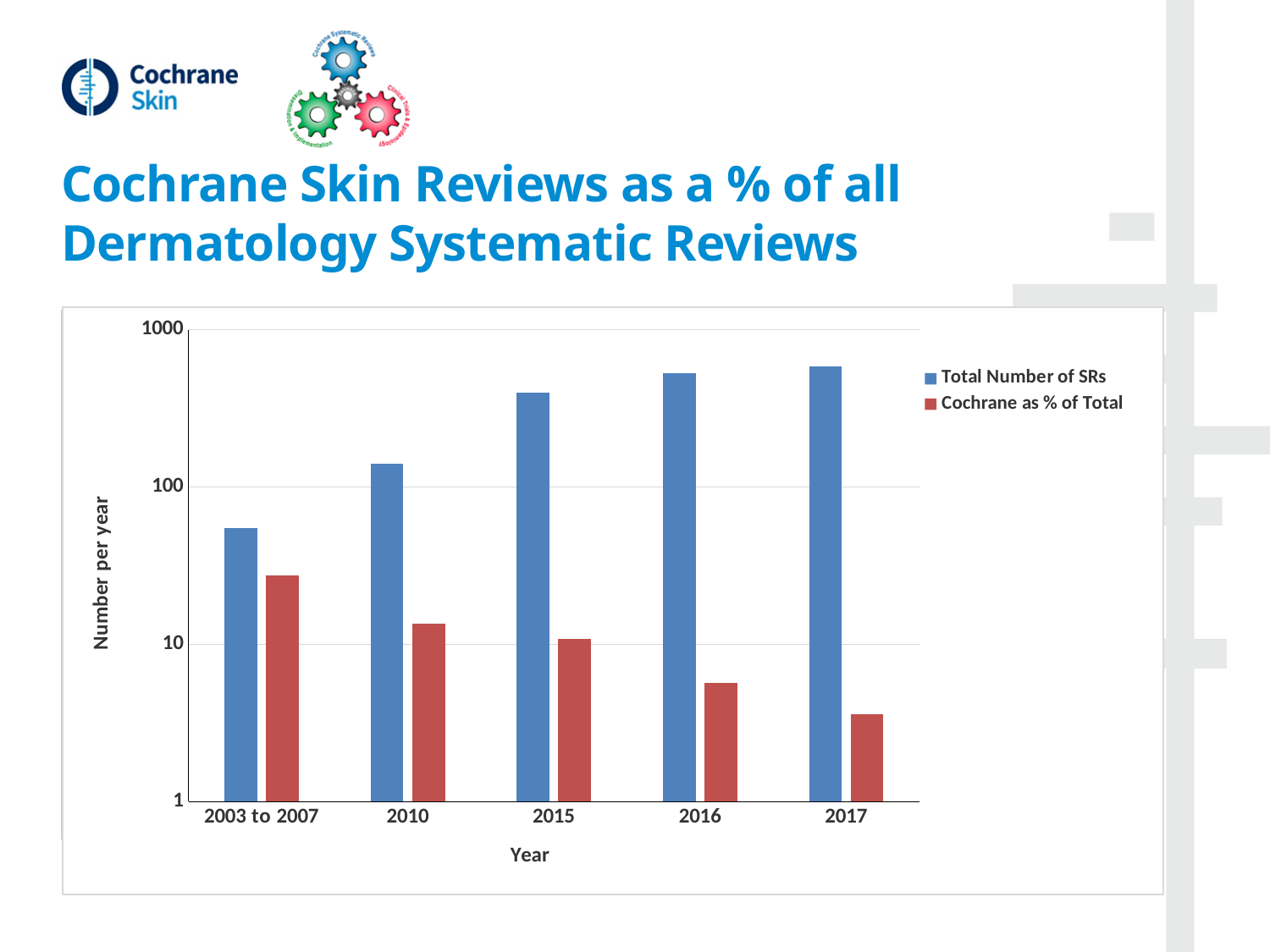
Which year category has the highest value for Cochrane as % of Total? 2003 to 2007 How many year categories are shown on the x axis? 5 What kind of chart is shown on the slide? Bar chart Does the Cochrane as % of Total series rise or fall across the years from 2003 to 2007 through 2017? Fall Is the Total Number of SRs for 2010 greater or less than 100? greater Is the Total Number of SRs for 2003 to 2007 greater or less than 100? less How many series does the chart's legend list? 2 Is the value for Cochrane as % of Total in 2003 to 2007 greater or less than 10? greater Which year category has the lowest value for Total Number of SRs? 2003 to 2007 What is the label of the chart's vertical axis? Number per year Which year category has the lowest value for Cochrane as % of Total? 2017